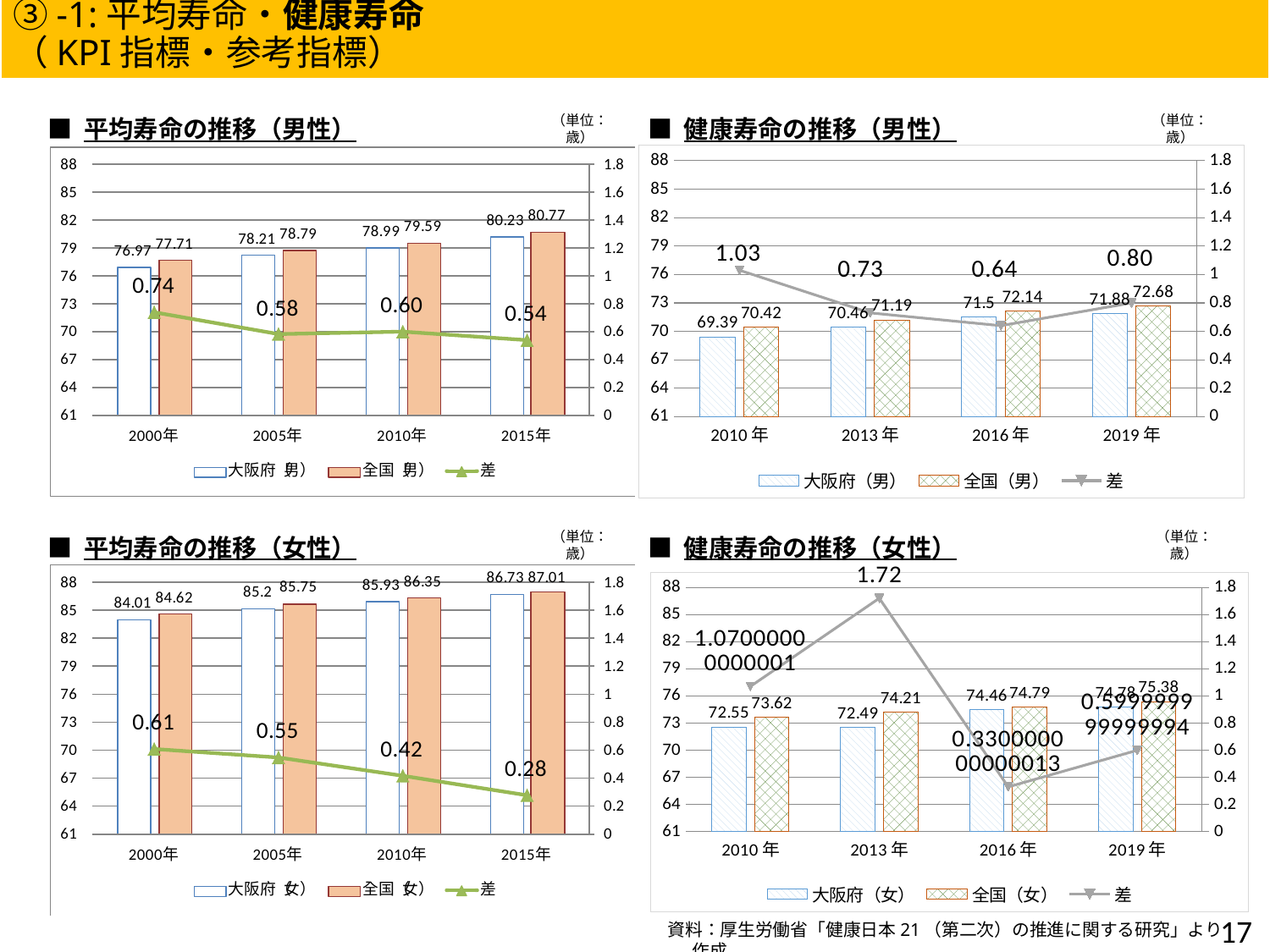
「平均寿命の推移（男性）」のグラフで、差が最も大きい年はどれですか？ 2000年 「健康寿命の推移（女性）」のグラフには、いくつの年（カテゴリ）が表示されていますか？ 4 「健康寿命の推移（女性）」のグラフで、2016年の大阪府（女）の値はいくつですか？ 74.46 「健康寿命の推移（女性）」のグラフで、差が最も大きい年はどれですか？ 2013年 「健康寿命の推移（男性）」のグラフで、凡例にはいくつの系列がありますか？ 3 「平均寿命の推移（男性）」のグラフで、2015年の大阪府（男）の値はいくつですか？ 80.23 「健康寿命の推移（男性）」のグラフで、2013年の全国（男）の値はいくつですか？ 71.19 「平均寿命の推移（男性）」のグラフで、2010年の全国（男）と大阪府（男）の差はいくつですか？ 0.60 「平均寿命の推移（女性）」のグラフで、2005年の大阪府（女）の値はいくつですか？ 85.2 「平均寿命の推移（女性）」のグラフで、2015年の全国（女）と大阪府（女）の差はいくつですか？ 0.28 「健康寿命の推移（男性）」のグラフで、差が最も小さい年はどれですか？ 2016年 「平均寿命の推移（女性）」のグラフで、差は2000年から2015年にかけて増加していますか、減少していますか？ 減少